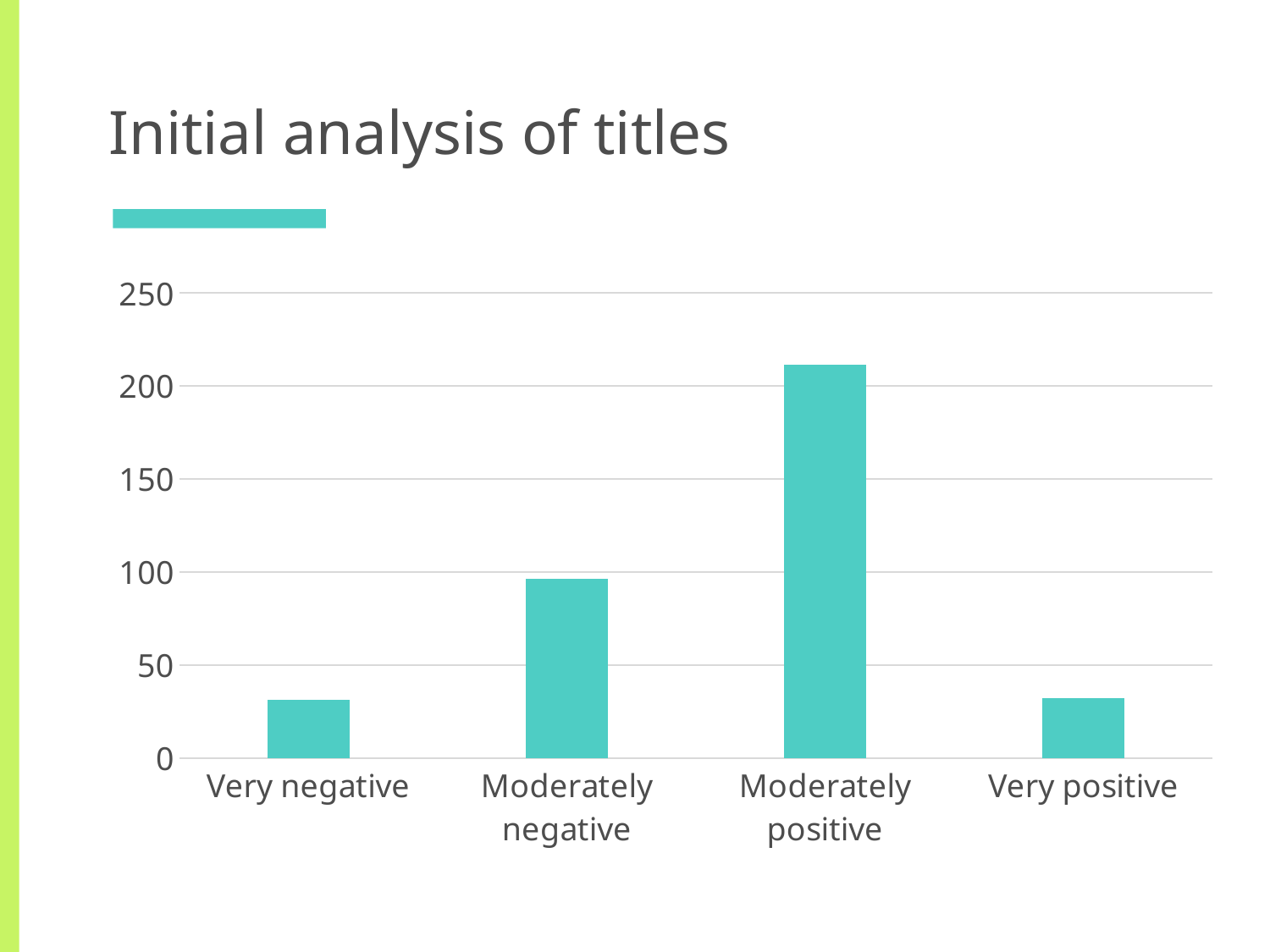
Is the value for Very positive greater or less than 50? less Is the value for Moderately positive greater or less than 200? greater Is the value for Moderately negative greater or less than 50? greater How many categories are shown on the x axis of the chart? 4 Which category has the highest value in the chart? Moderately positive Which is larger, the value for Moderately positive or the value for Moderately negative? Moderately positive What is the title of the slide containing the chart? Initial analysis of titles What kind of chart is shown on the slide? bar chart Which is larger, the value for Moderately negative or the value for Very negative? Moderately negative What is the highest value shown on the y axis of the chart? 250